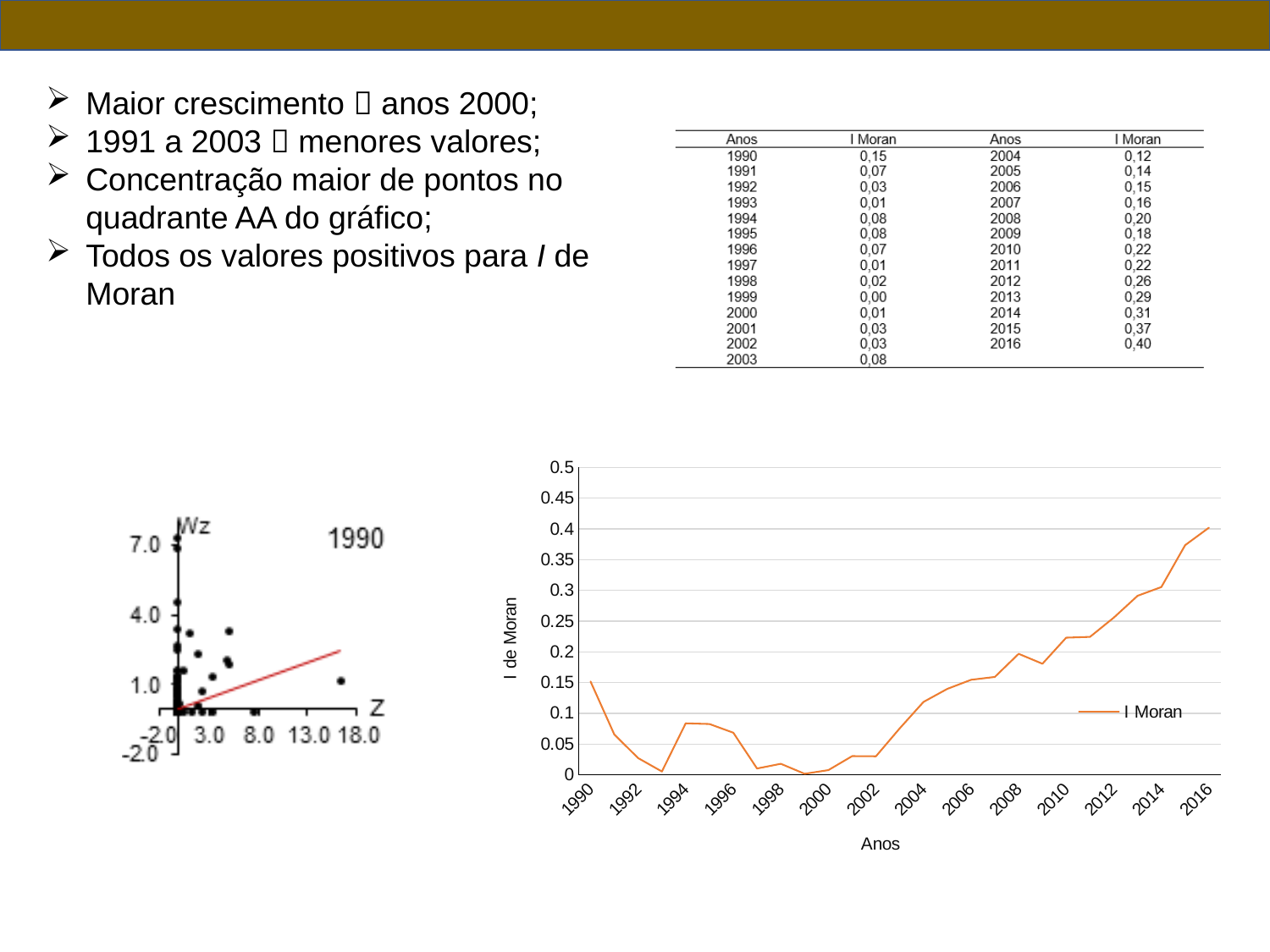
What is the legend entry of the line chart? I Moran In the line chart, is the I Moran value for 1991 greater or less than 0.1? less How many series does the legend of the line chart list? 1 In the line chart, is the I Moran value for 2013 greater or less than 0.25? greater In the line chart, do the I Moran values rise or fall from 2004 to 2016? rise What is the y-axis title of the line chart? I de Moran What kind of chart is the chart on the right with the x axis labelled Anos? line chart In the line chart, which year has the highest I Moran value? 2016 In the line chart, is the I Moran value for 2015 greater or less than 0.3? greater In the line chart, which year has the larger I Moran value, 2000 or 2010? 2010 In the line chart, what is the I Moran value for 2016? 0.4 What kind of chart is the small chart on the left labelled 1990 with axes Wz and Z? scatter chart